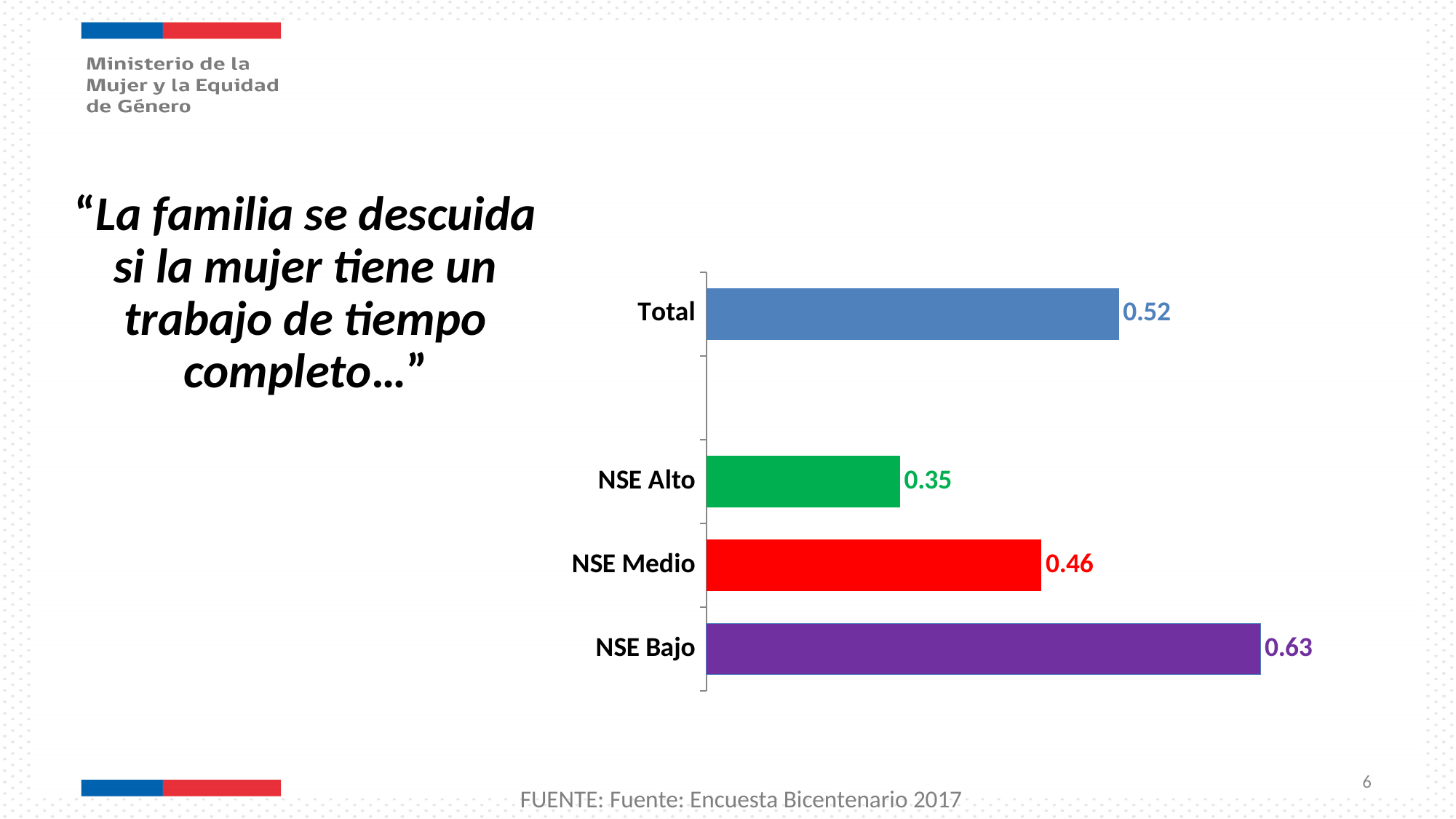
Which is larger, the value for NSE Medio or the value for NSE Alto? NSE Medio What is the difference between the values for NSE Bajo and NSE Alto? 0.28 What is the value for Total? 0.52 What is the difference between the values for Total and NSE Medio? 0.06 What is the value for NSE Bajo? 0.63 What is the value for NSE Medio? 0.46 Which category has the highest value? NSE Bajo Which category has the lowest value? NSE Alto What colour is the bar for NSE Bajo? Purple What is the value for NSE Alto? 0.35 How many categories are shown in the chart? 4 What kind of chart is shown on the slide? Bar chart